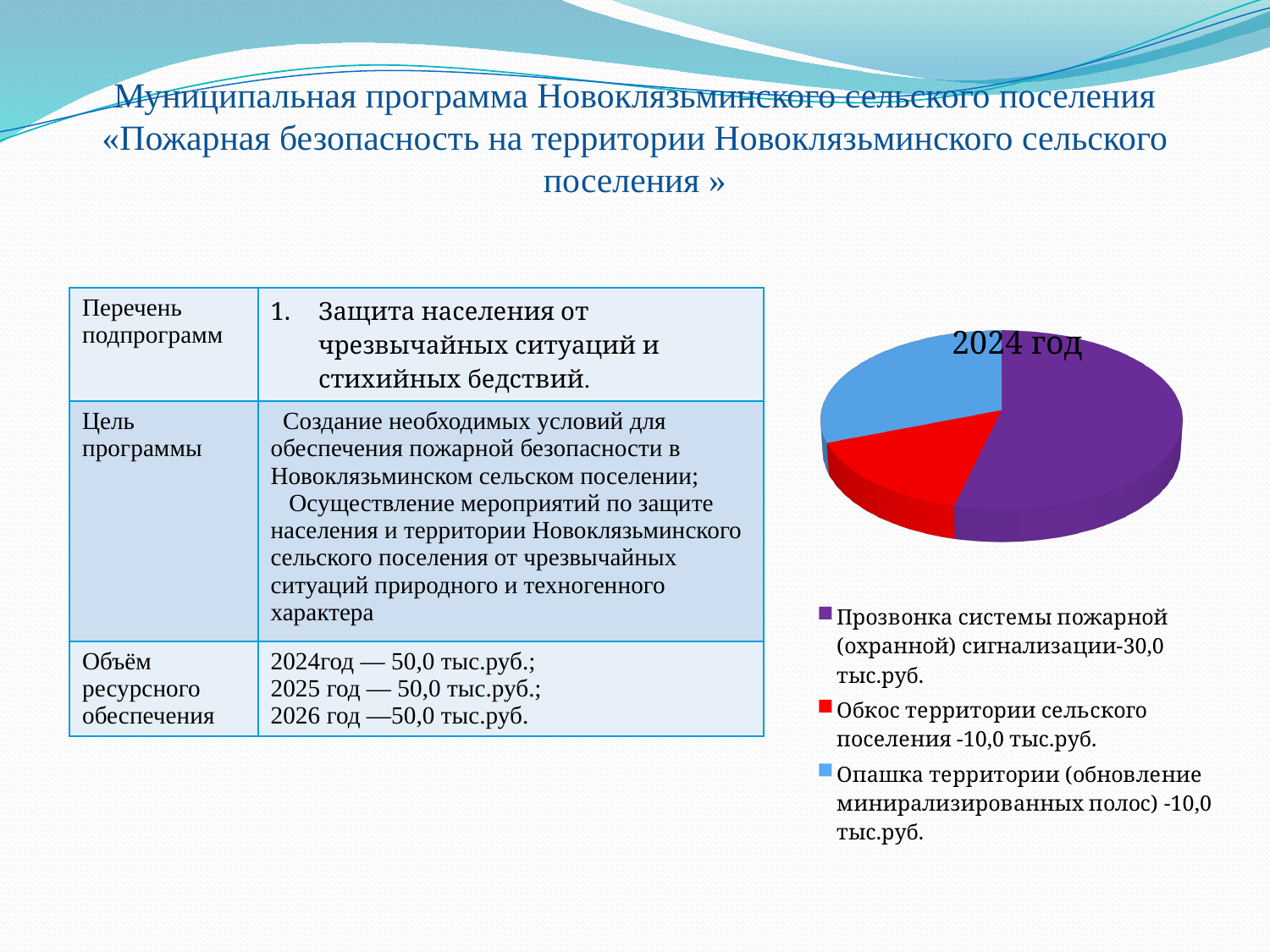
Which category has the largest slice in the pie chart? Прозвонка системы пожарной (охранной) сигнализации What kind of chart is shown on the slide? Pie chart What is the value for Обкос территории сельского поселения in the pie chart? 10,0 тыс.руб. How many slices does the pie chart have? 3 What is the difference between the values for Прозвонка системы пожарной (охранной) сигнализации and Обкос территории сельского поселения? 20,0 тыс.руб. What is the value for Опашка территории (обновление минирализированных полос) in the pie chart? 10,0 тыс.руб. What is the value for Прозвонка системы пожарной (охранной) сигнализации in the pie chart? 30,0 тыс.руб. What is the title of the pie chart? 2024 год Which is larger in the pie chart: Прозвонка системы пожарной (охранной) сигнализации or Обкос территории сельского поселения? Прозвонка системы пожарной (охранной) сигнализации How many entries does the legend of the pie chart list? 3 What colour is the slice for Прозвонка системы пожарной (охранной) сигнализации? Purple